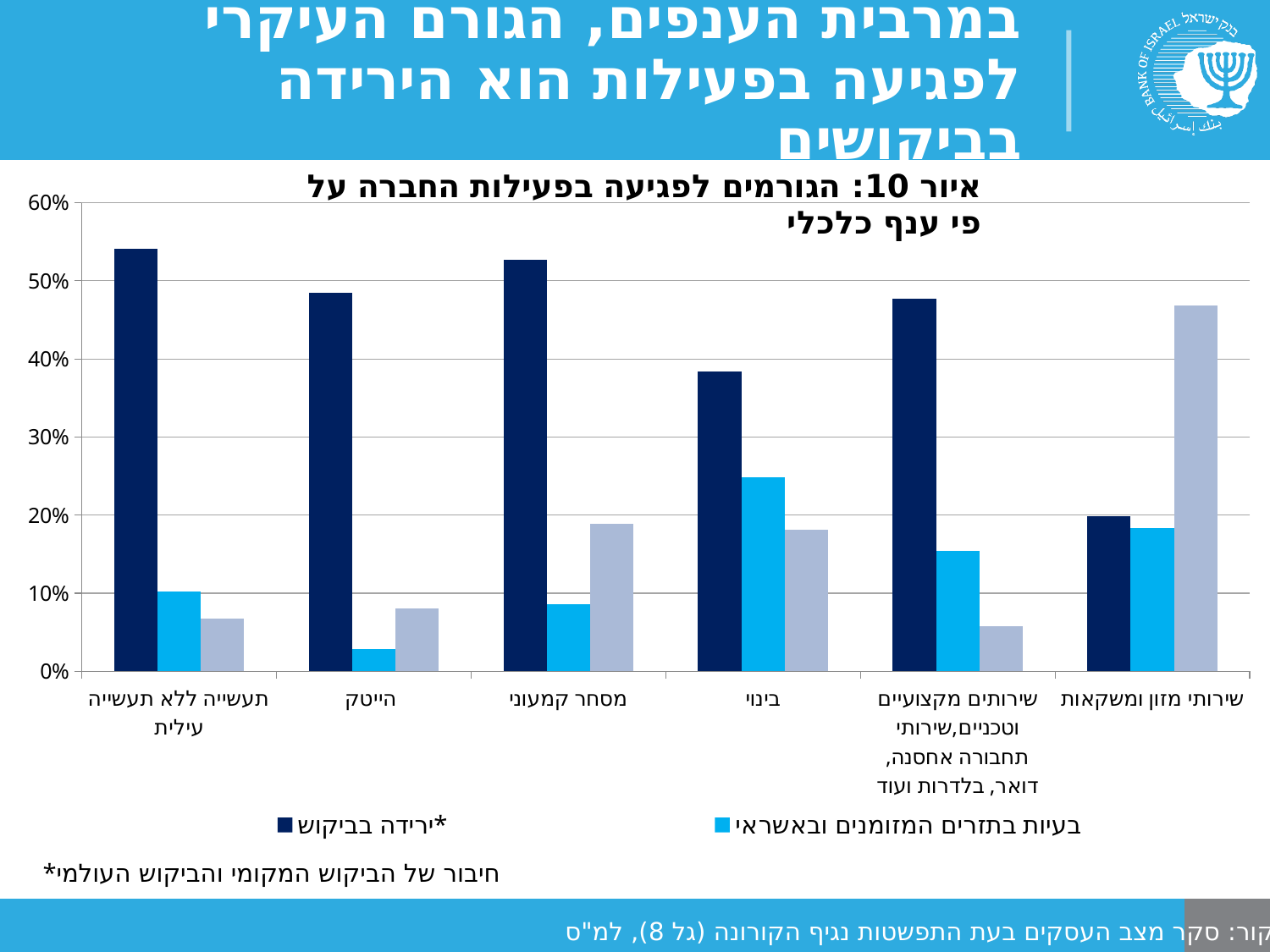
Which sector has the lowest value for בעיות בתזרים המזומנים ובאשראי? הייטק Is the value for ירידה בביקוש in בינוי greater or less than 40%? less How many economic sectors (categories) are shown on the x axis of the chart? 6 Is the value for בעיות בתזרים המזומנים ובאשראי in בינוי greater or less than 20%? greater What is the title of the chart? איור 10: הגורמים לפגיעה בפעילות החברה על פי ענף כלכלי Which has a larger value for בעיות בתזרים המזומנים ובאשראי: שירותים מקצועיים וטכניים or הייטק? שירותים מקצועיים וטכניים Which sector has the lowest value for ירידה בביקוש? שירותי מזון ומשקאות Which sector has the highest value for בעיות בתזרים המזומנים ובאשראי? בינוי Which has a larger value for ירידה בביקוש: הייטק or בינוי? הייטק How many series does the chart's legend list? 2 What kind of chart is shown on the slide? bar chart Is the value for ירידה בביקוש in שירותי מזון ומשקאות greater or less than 30%? less